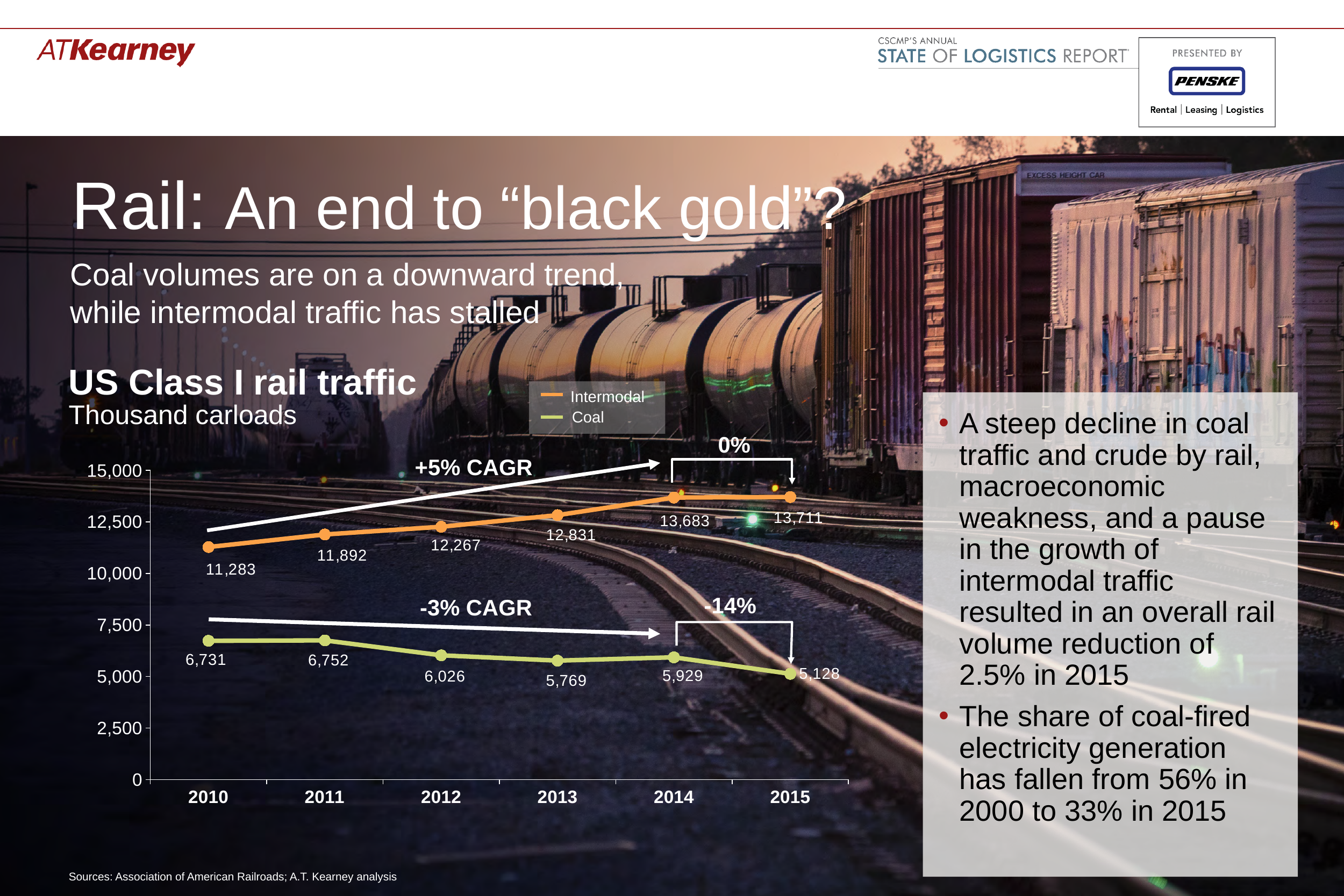
How many series does the legend list? 2 In which year was Coal traffic lowest? 2015 How many years are shown on the x axis? 6 What was the Intermodal value in 2010? 11,283 In which year was Intermodal traffic highest? 2015 What was the Coal value in 2013? 5,769 What was the Coal value in 2015? 5,128 Is the Coal value for 2011 greater or less than 7,500? less What kind of chart is shown? line chart Which was larger in 2012, Intermodal or Coal? Intermodal Does Coal traffic rise or fall from 2010 to 2015? fall What is the difference between the Intermodal and Coal values in 2014? 7,754